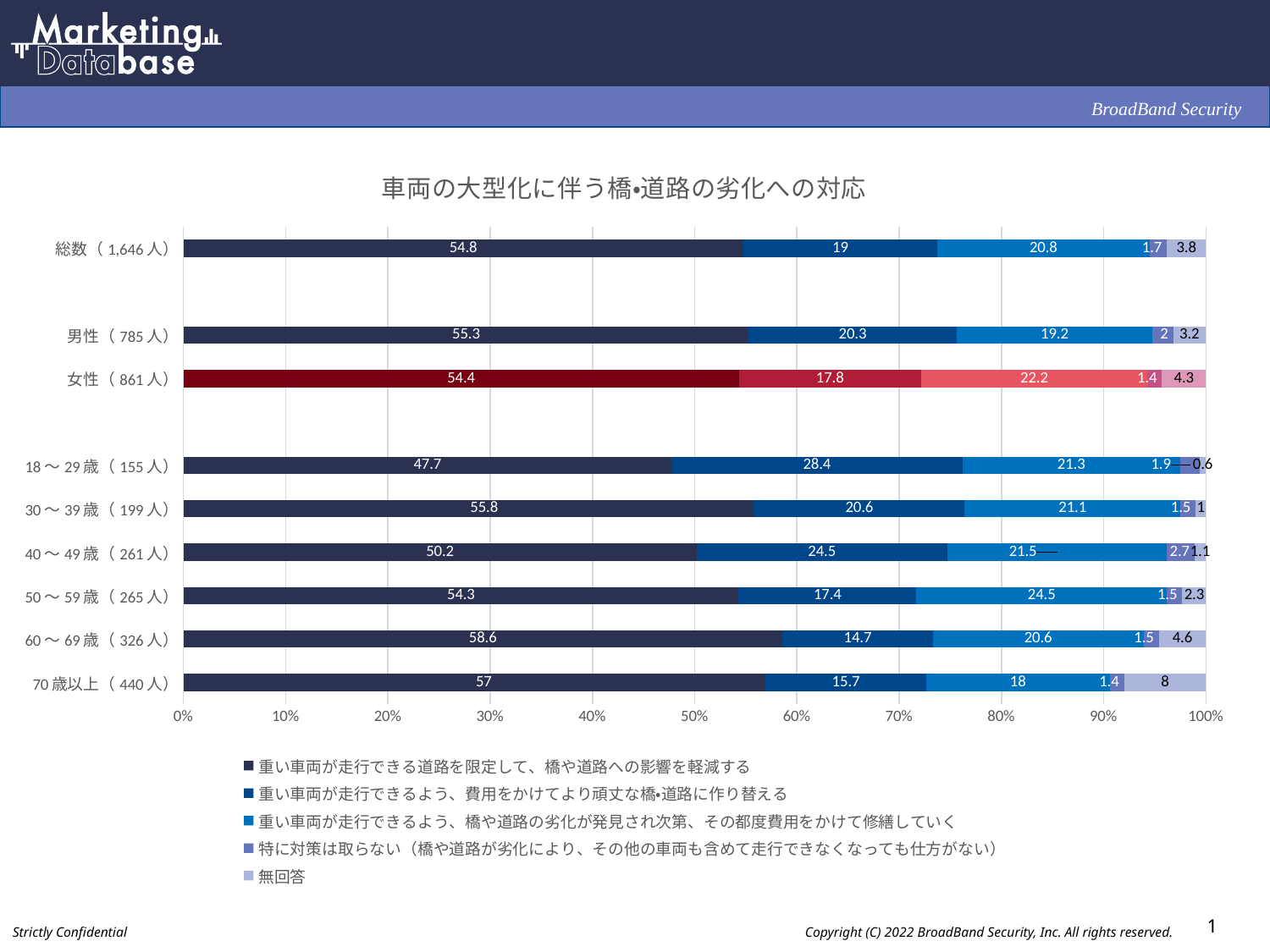
What kind of chart is shown on the slide? Stacked bar chart What is the difference between the 無回答 values for 70歳以上 (440人) and 18～29歳 (155人)? 7.4 What is the value of the third series (その都度費用をかけて修繕していく) for 50～59歳 (265人)? 24.5 What is the value of the first series (重い車両が走行できる道路を限定して、橋や道路への影響を軽減する) for 総数 (1,646人)? 54.8 What is the title of the chart? 車両の大型化に伴う橋•道路の劣化への対応 How many series does the legend list? 5 How many categories are shown on the chart? 9 Which category has the lowest value for the first series (重い車両が走行できる道路を限定して、橋や道路への影響を軽減する)? 18～29歳 (155人) What is the value of 無回答 for 70歳以上 (440人)? 8 What is the value of the second series (費用をかけてより頑丈な橋•道路に作り替える) for 18～29歳 (155人)? 28.4 Which category has the highest value for the first series (重い車両が走行できる道路を限定して、橋や道路への影響を軽減する)? 60～69歳 (326人) Which is larger: the second series value for 男性 (785人) or for 女性 (861人)? 男性 (785人)